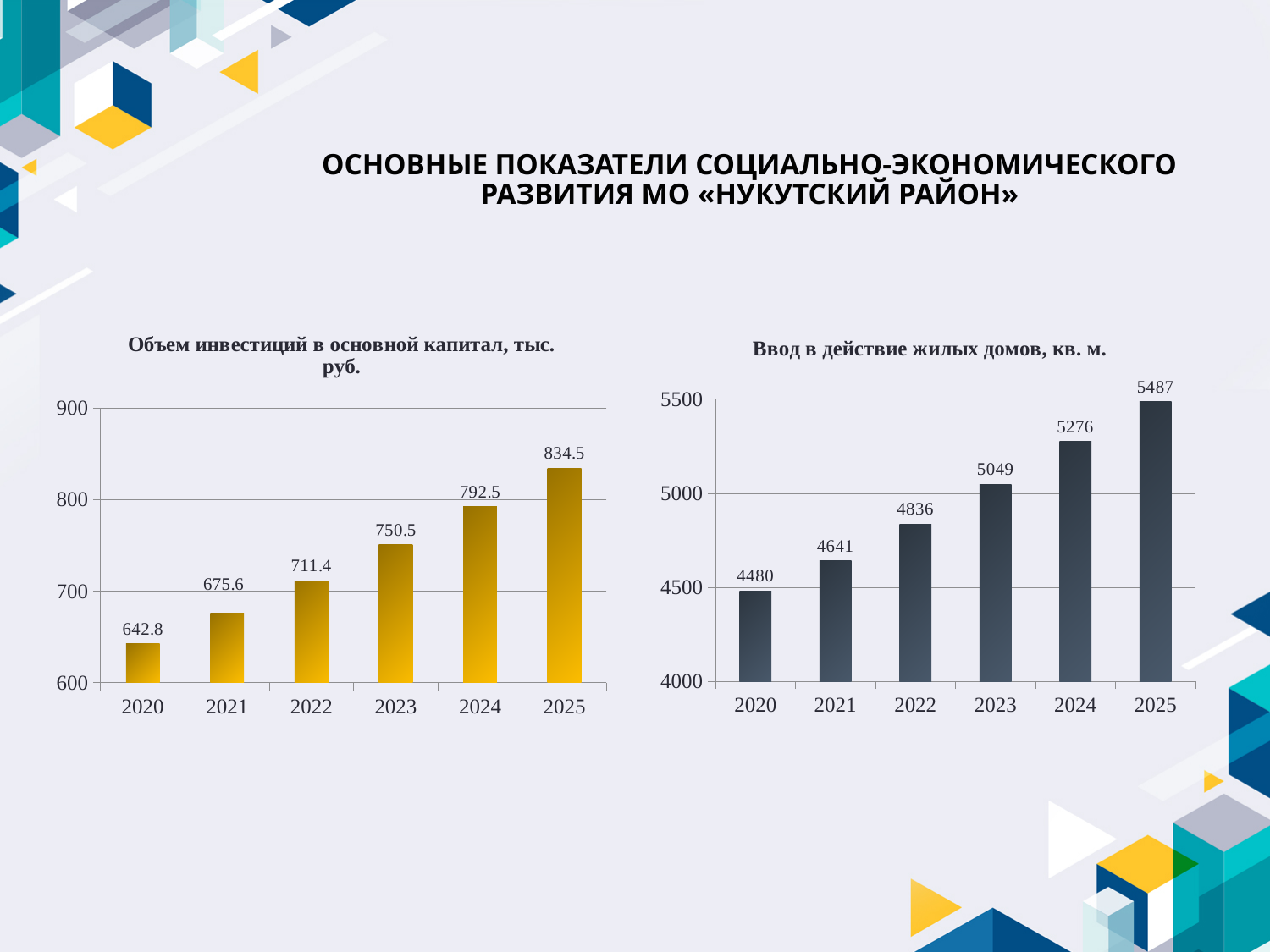
In the left chart 'Объем инвестиций в основной капитал, тыс. руб.', which year has the highest value? 2025 What kind of chart is the right chart 'Ввод в действие жилых домов, кв. м.'? bar chart In the right chart 'Ввод в действие жилых домов, кв. м.', what is the difference between the values for 2024 and 2023? 227 In the left chart 'Объем инвестиций в основной капитал, тыс. руб.', what is the difference between the values for 2025 and 2020? 191.7 In the right chart 'Ввод в действие жилых домов, кв. м.', do the values rise or fall from 2020 to 2025? rise What colour are the bars in the left chart 'Объем инвестиций в основной капитал, тыс. руб.'? yellow In the left chart 'Объем инвестиций в основной капитал, тыс. руб.', which is larger: the value for 2022 or the value for 2021? 2022 In the right chart 'Ввод в действие жилых домов, кв. м.', what is the value for 2021? 4641 How many years are shown on the x axis of the left chart 'Объем инвестиций в основной капитал, тыс. руб.'? 6 In the right chart 'Ввод в действие жилых домов, кв. м.', which year has the lowest value? 2020 In the left chart 'Объем инвестиций в основной капитал, тыс. руб.', what is the value for 2023? 750.5 In the right chart 'Ввод в действие жилых домов, кв. м.', is the value for 2022 greater or less than 5000? less